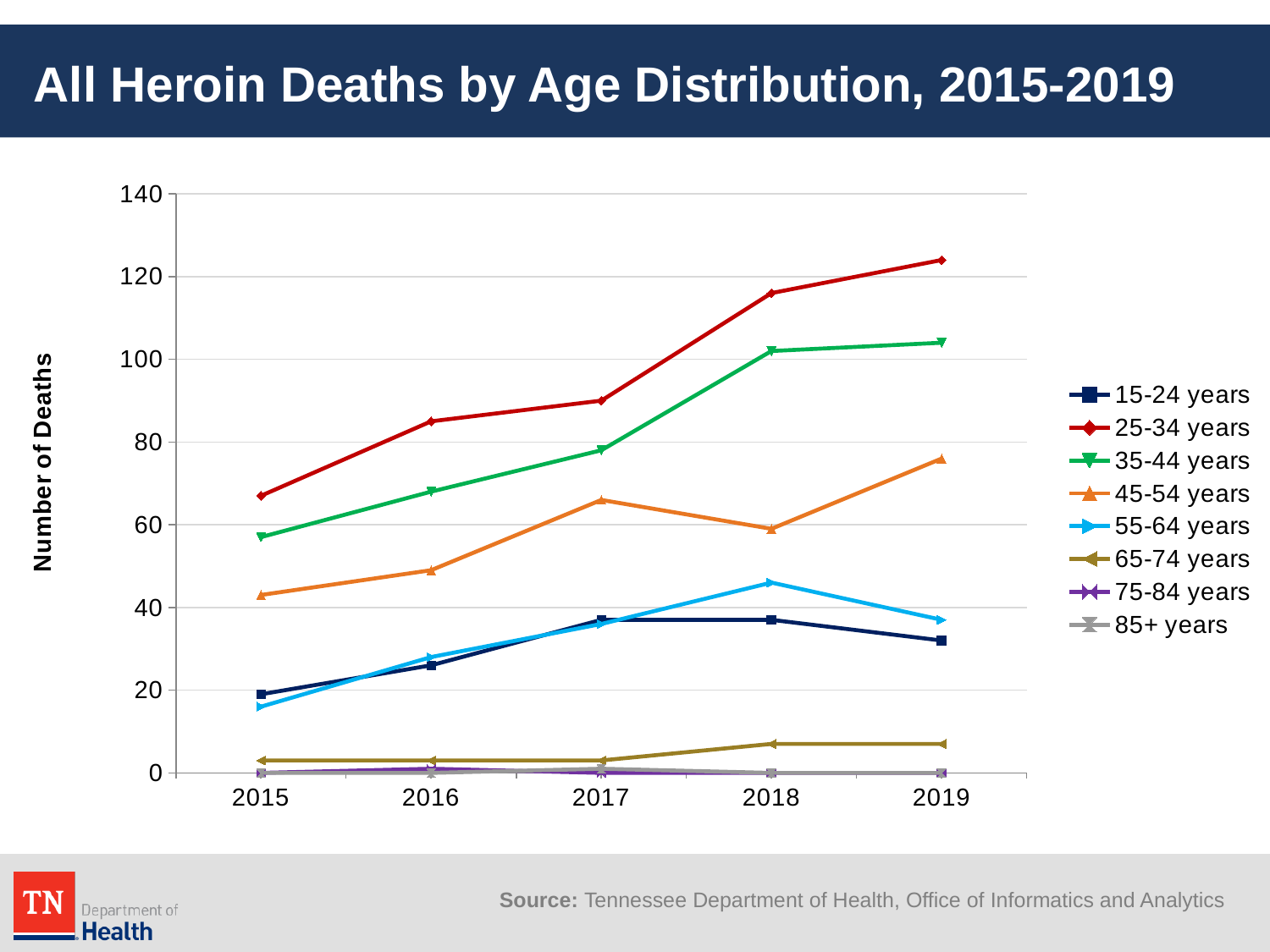
Which age group had the highest number of heroin deaths in 2015? 25-34 years Is the value for 55-64 years in 2018 greater or less than 40? greater How many years are shown along the x axis? 5 Do the deaths for the 25-34 years group rise or fall from 2015 to 2019? rise Is the value for 25-34 years in 2019 greater or less than 100? greater What kind of chart is shown on the slide? line chart In 2018, which age group had more deaths: 45-54 years or 55-64 years? 45-54 years Which age group had the highest number of heroin deaths in 2019? 25-34 years Is the value for 45-54 years in 2019 greater or less than 80? less What is the label on the y axis of the chart? Number of Deaths How many age groups does the legend list? 8 In 2016, which age group had more deaths: 35-44 years or 45-54 years? 35-44 years